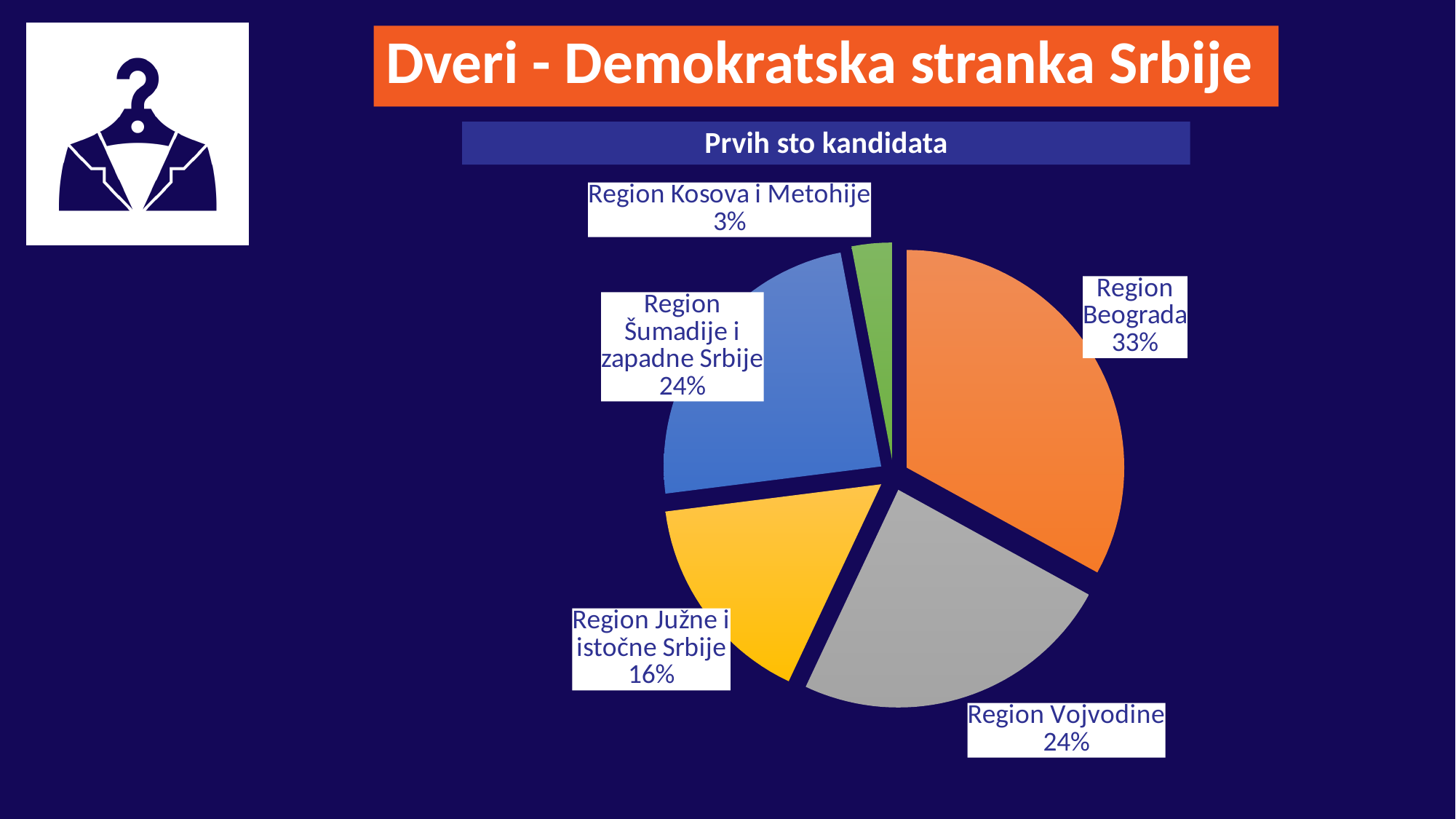
What is the subtitle shown above the pie chart? Prvih sto kandidata Which region has the smallest slice of the pie? Region Kosova i Metohije What is the value shown for Region Šumadije i zapadne Srbije? 24% Which region has the largest slice of the pie? Region Beograda What is the value shown for Region Južne i istočne Srbije? 16% What share of the pie does Region Kosova i Metohije have? 3% What kind of chart is shown on the slide? pie chart How many regions are shown in the pie chart? 5 What share of the pie does Region Beograda have? 33% Which is larger, the share of Region Vojvodine or the share of Region Južne i istočne Srbije? Region Vojvodine What is the difference between the shares of Region Beograda and Region Južne i istočne Srbije? 17% What is the value shown for Region Vojvodine? 24%